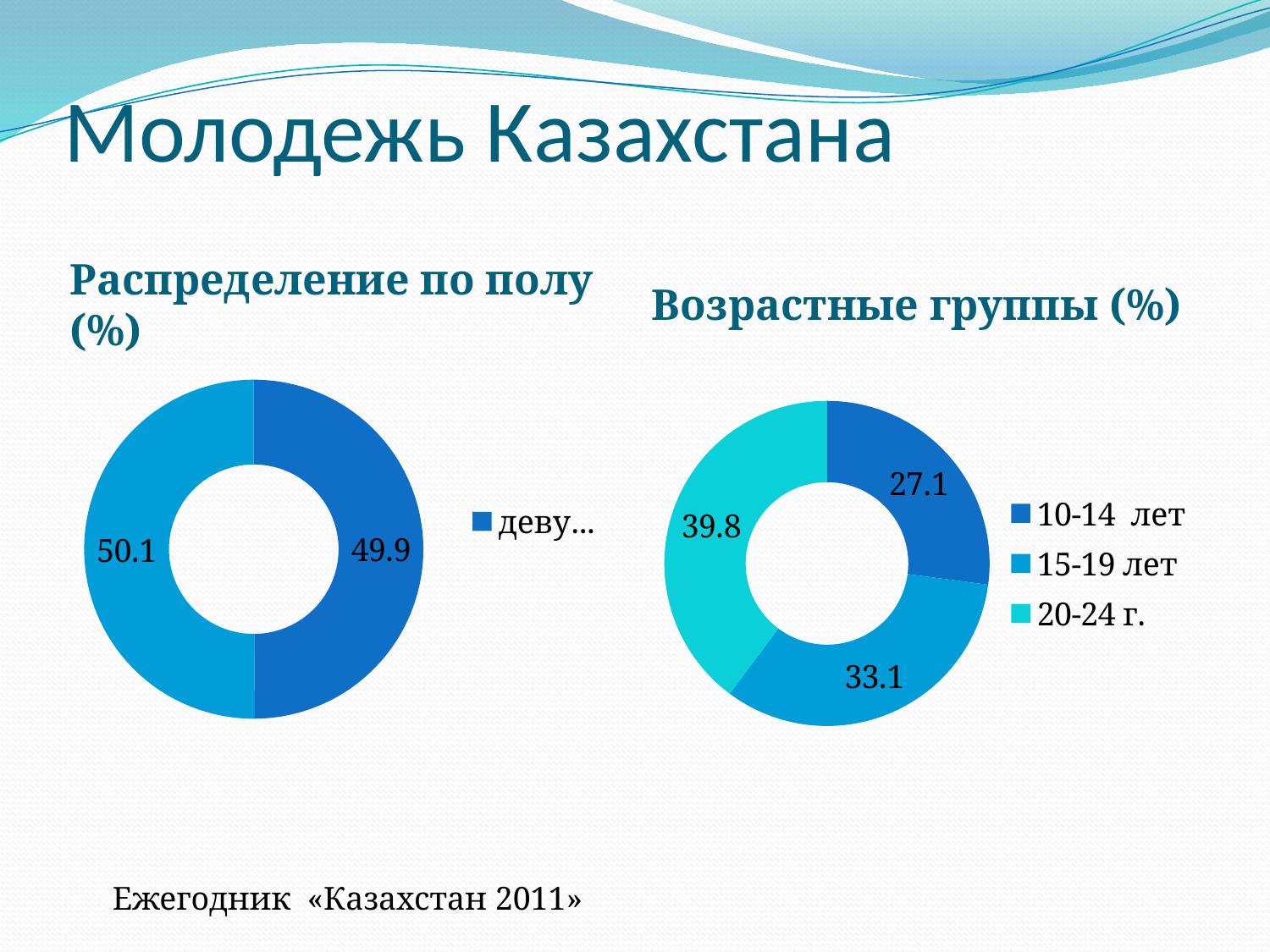
In the chart titled "Возрастные группы (%)", what is the difference between the values for 20-24 г. and 10-14 лет? 12.7 In the chart titled "Распределение по полу (%)", what value is shown on the dark blue slice? 49.9 In the chart titled "Возрастные группы (%)", which is larger: the value for 15-19 лет or the value for 10-14 лет? 15-19 лет In the chart titled "Возрастные группы (%)", which age group has the largest share? 20-24 г. In the chart titled "Возрастные группы (%)", what is the value for 10-14 лет? 27.1 In the chart titled "Распределение по полу (%)", how many slices does the chart have? 2 In the chart titled "Возрастные группы (%)", what is the value for 15-19 лет? 33.1 In the chart titled "Возрастные группы (%)", how many entries does the legend list? 3 In the chart titled "Возрастные группы (%)", which age group has the smallest share? 10-14 лет What kind of chart is the chart titled "Распределение по полу (%)"? Doughnut chart In the chart titled "Возрастные группы (%)", what is the value for 20-24 г.? 39.8 In the chart titled "Возрастные группы (%)", how many age groups are shown? 3